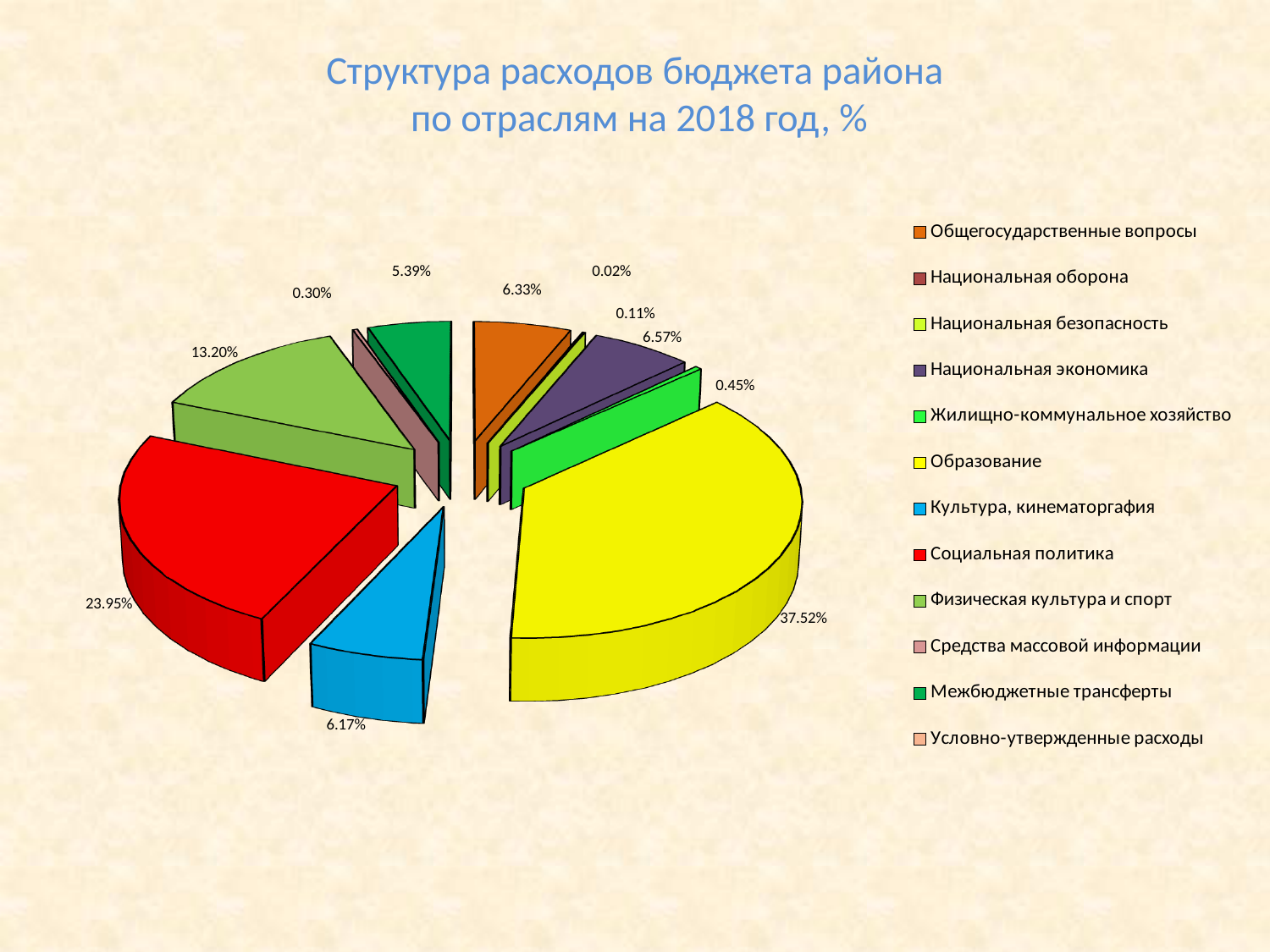
What percentage is labelled for Физическая культура и спорт? 13.20% What share is shown for Социальная политика? 23.95% What percentage is shown for Межбюджетные трансферты? 5.39% What type of chart is shown on the slide? Pie chart How many categories does the legend list? 12 By how many percentage points does Образование exceed Социальная политика? 13.57 Which category has the largest slice of the pie? Образование Which is larger, the share for Национальная экономика or for Общегосударственные вопросы? Национальная экономика What is the title of the chart? Структура расходов бюджета района по отраслям на 2018 год, % What share is labelled for Общегосударственные вопросы? 6.33% What share is shown for Культура, кинематоргафия? 6.17% What share of the budget expenditure goes to Образование? 37.52%